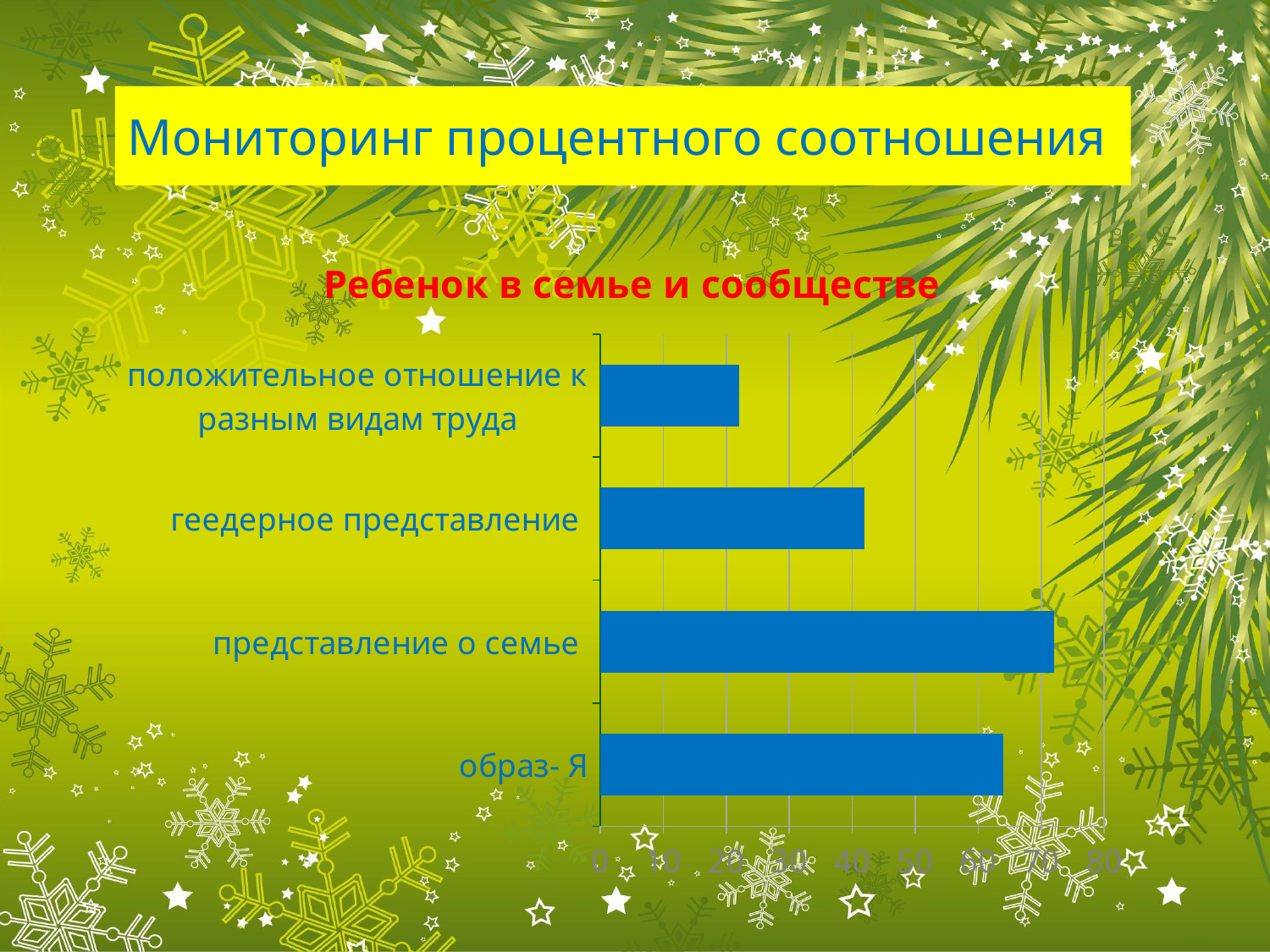
What kind of chart is shown on the slide? bar chart Is the value for положительное отношение к разным видам труда greater or less than 30? less What is the title of the chart? Ребенок в семье и сообществе Which is larger, the value for представление о семье or the value for образ- Я? представление о семье Is the value for геедерное представление greater or less than 50? less Is the value for образ- Я greater or less than 60? greater What colour are the bars in the chart? blue How many categories does the chart show? 4 Which is larger, the value for геедерное представление or the value for положительное отношение к разным видам труда? геедерное представление Which category has the highest value? представление о семье Which category has the lowest value? положительное отношение к разным видам труда